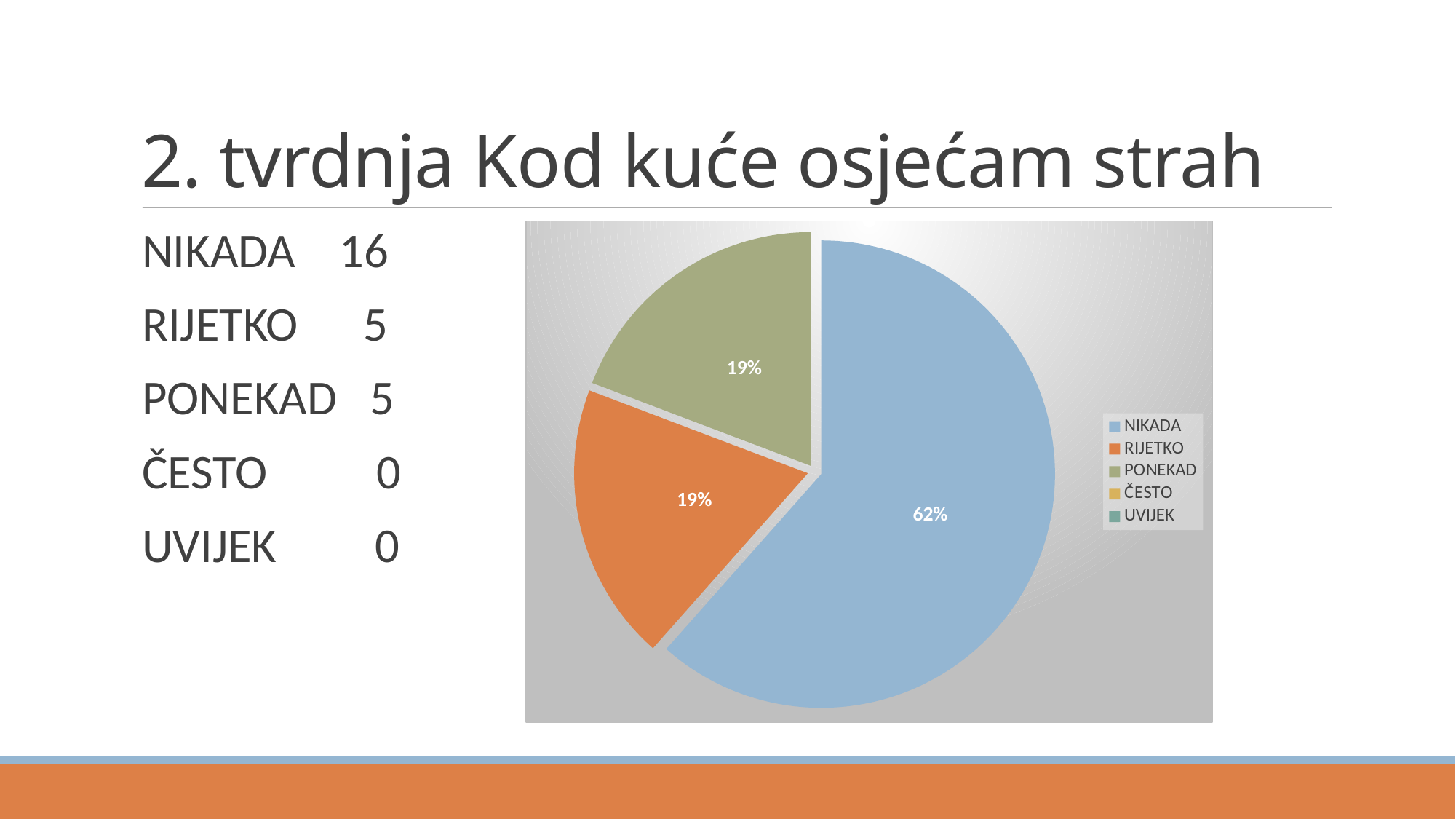
What share of the pie does NIKADA have? 62% Is the share for NIKADA greater or less than 50%? greater What share of the pie does RIJETKO have? 19% Is the slice for NIKADA larger or smaller than the slice for RIJETKO? larger What kind of chart is shown on the slide? pie chart Which colour represents NIKADA in the legend? blue How many entries does the legend list? 5 What share of the pie does PONEKAD have? 19% How many slices are visible in the pie chart? 3 Which category has the largest slice of the pie? NIKADA What is the difference in percentage points between the NIKADA slice and the PONEKAD slice? 43 percentage points Which colour represents RIJETKO in the legend? orange